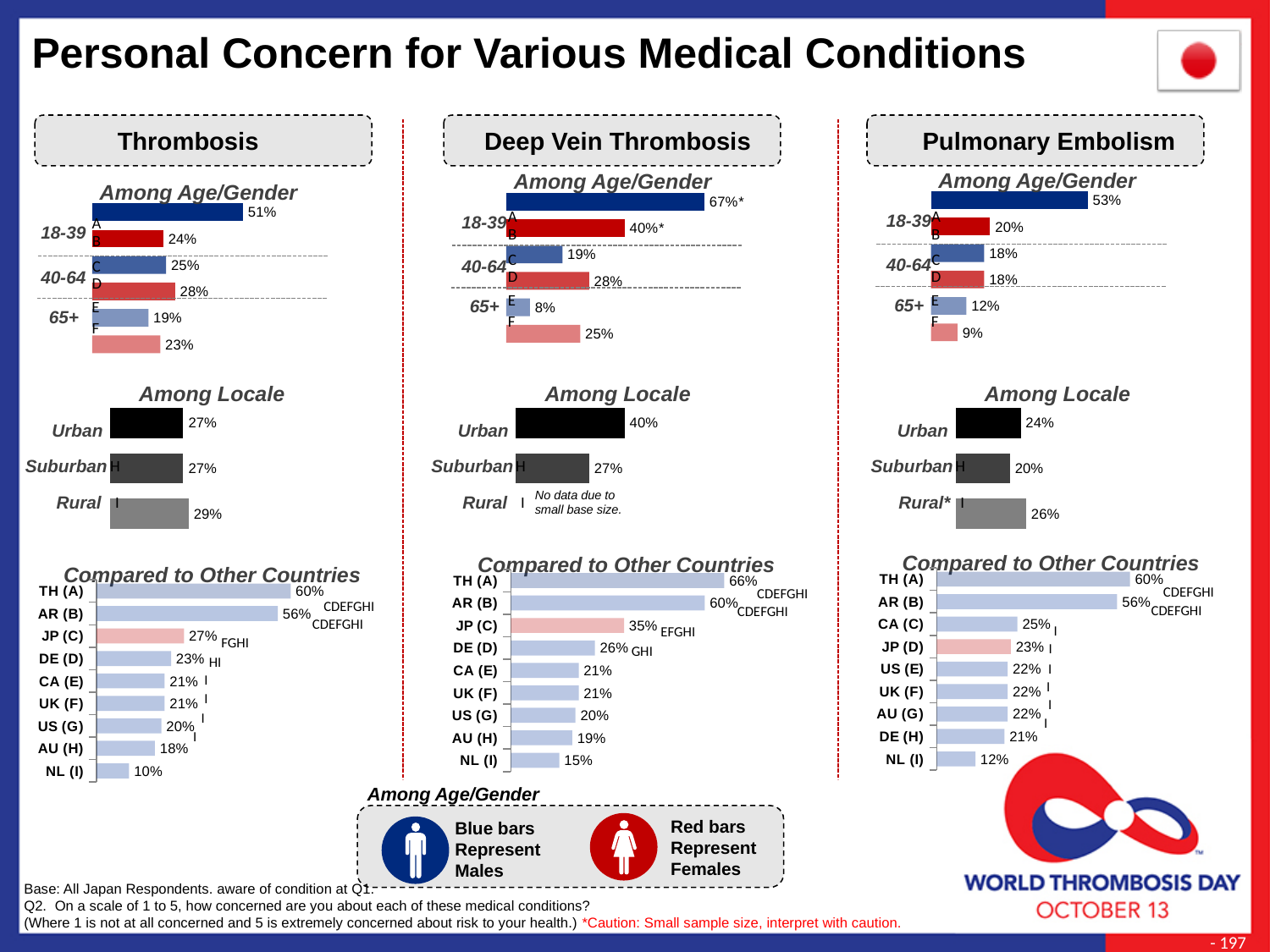
In the Thrombosis 'Compared to Other Countries' chart, what is the value for JP (C)? 27% How many countries are listed in the Thrombosis 'Compared to Other Countries' chart? 9 What type of chart is used in the 'Among Locale' section for Thrombosis? Bar chart In the Deep Vein Thrombosis 'Compared to Other Countries' chart, which country has the highest value? TH (A) In the Deep Vein Thrombosis 'Among Locale' chart, which is larger, Urban or Suburban? Urban In the Pulmonary Embolism 'Compared to Other Countries' chart, which country has the lowest value? NL (I) In the Pulmonary Embolism 'Among Age/Gender' chart, what is the value for females aged 65+ (bar F)? 9% According to the legend at the bottom of the slide, what do the red bars in the 'Among Age/Gender' charts represent? Females In the Deep Vein Thrombosis 'Among Locale' chart, what is shown for Rural? No data due to small base size. In the Deep Vein Thrombosis 'Among Age/Gender' chart, what is the value for males aged 18-39 (bar A)? 67%* In the Thrombosis 'Among Age/Gender' chart, what is the difference between the male (A) and female (B) values for ages 18-39? 27 percentage points In the Pulmonary Embolism 'Among Locale' chart, what is the value for Rural*? 26%